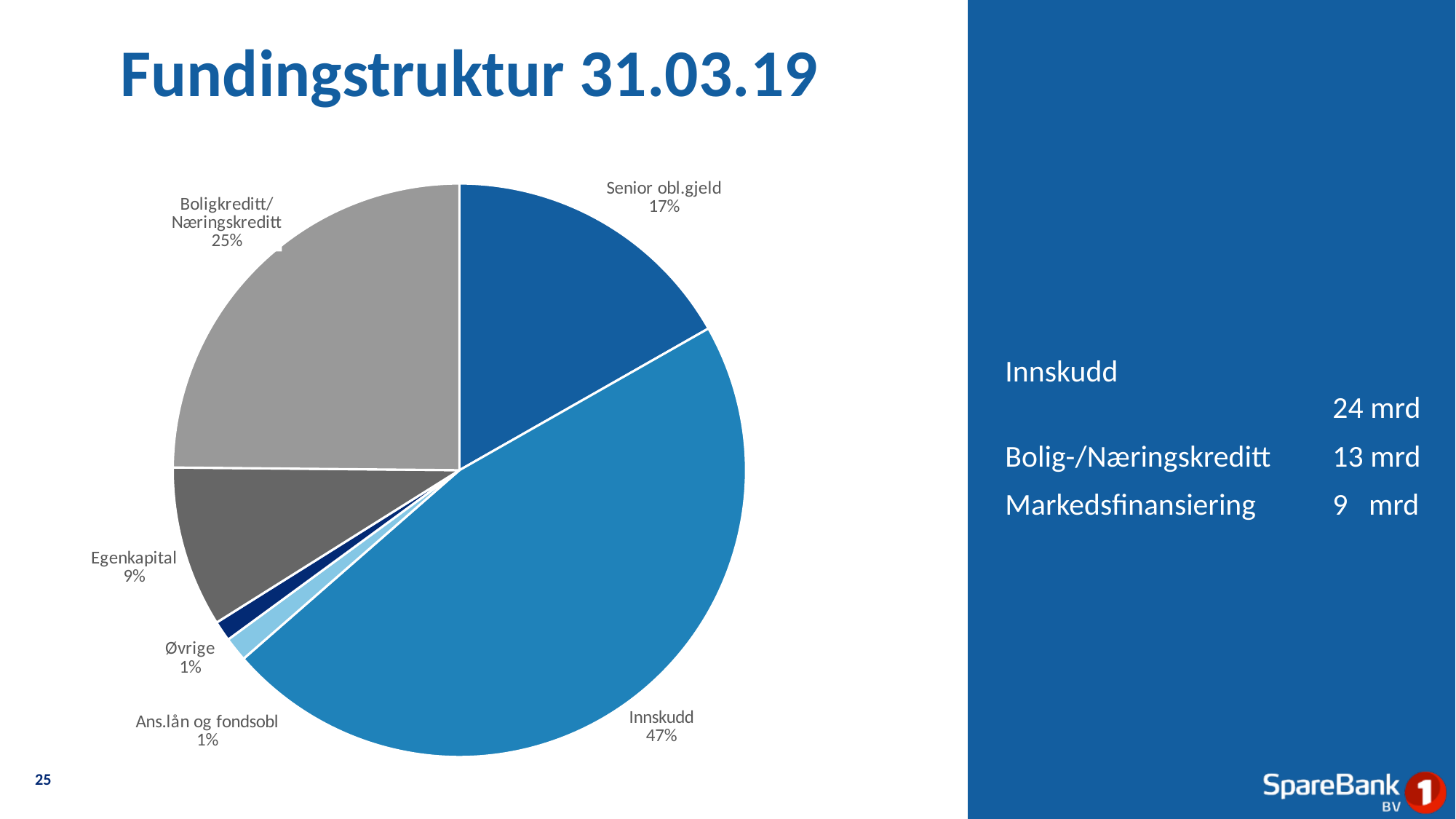
What type of chart is shown on the slide? Pie chart Which is larger, Senior obl.gjeld or Egenkapital? Senior obl.gjeld What share of the pie does Boligkreditt/Næringskreditt represent? 25% What is the title of the slide containing the pie chart? Fundingstruktur 31.03.19 What share of the pie does Egenkapital represent? 9% How many slices does the pie chart have? 6 What is the difference in percentage points between Innskudd and Boligkreditt/Næringskreditt? 22 What is the combined share of Senior obl.gjeld and Egenkapital? 26% What share of the pie does Øvrige represent? 1% What share of the pie does Senior obl.gjeld represent? 17% Which slice of the pie is the largest? Innskudd What share of the pie does Innskudd represent? 47%